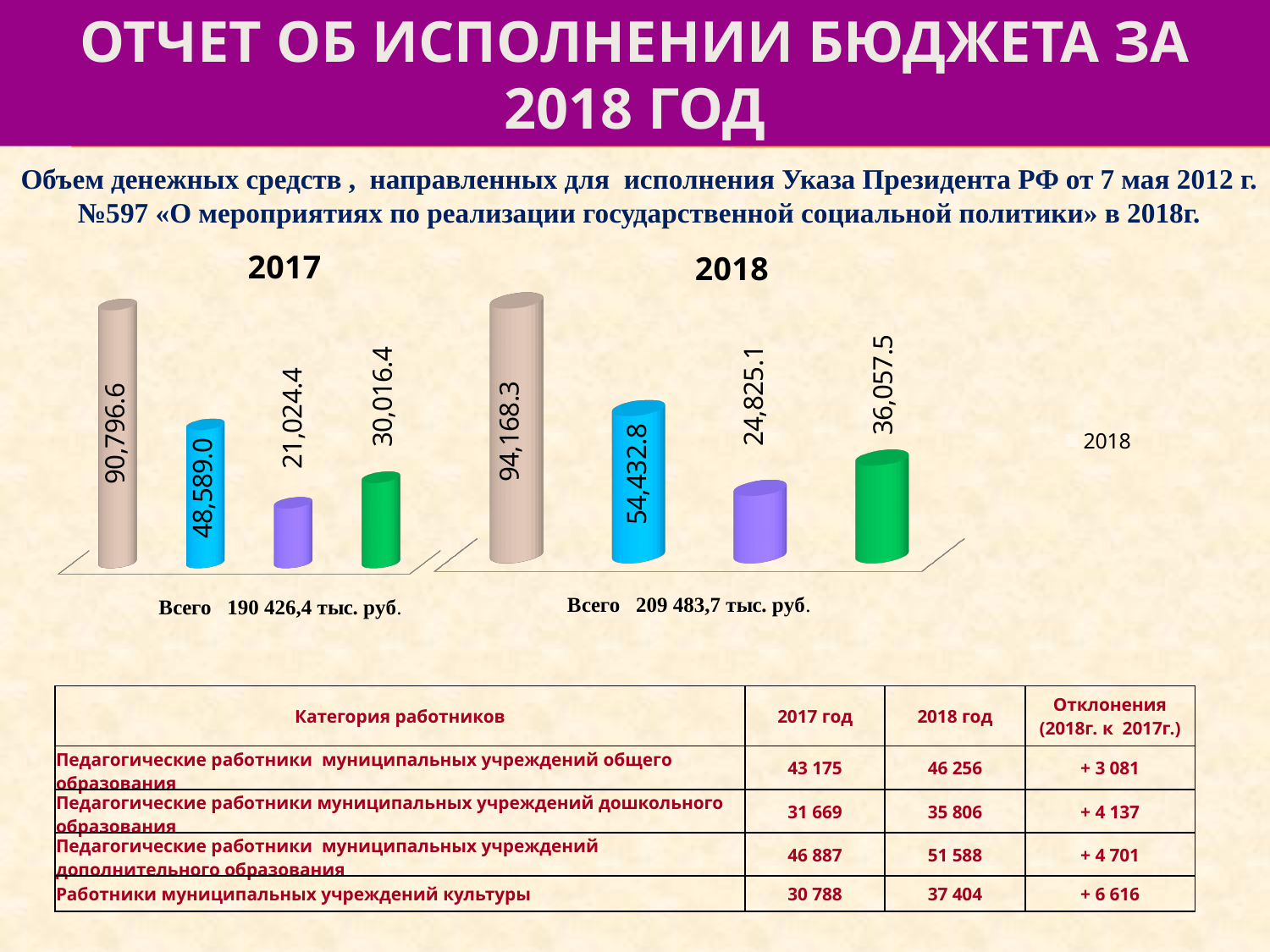
How many bars are in the 2017 chart? 4 In the 2017 chart, what is the value of the purple bar? 21,024.4 What is the difference between the tan bar in the 2018 chart and the tan bar in the 2017 chart? 3,371.7 What total is printed below the 2018 chart? 209 483,7 тыс. руб. What total is printed below the 2017 chart? 190 426,4 тыс. руб. Which is larger: the green bar in the 2017 chart or the green bar in the 2018 chart? The green bar in the 2018 chart In the 2018 chart, which bar has the highest value? The first (tan) bar, 94,168.3 In the 2018 chart, what is the value of the green bar? 36,057.5 In the 2017 chart, which bar has the lowest value? The purple bar, 21,024.4 In the 2017 chart, what is the value of the first (tan) bar? 90,796.6 What type of chart is used for the 2017 and 2018 data? Bar chart In the 2018 chart, what is the value of the blue bar? 54,432.8